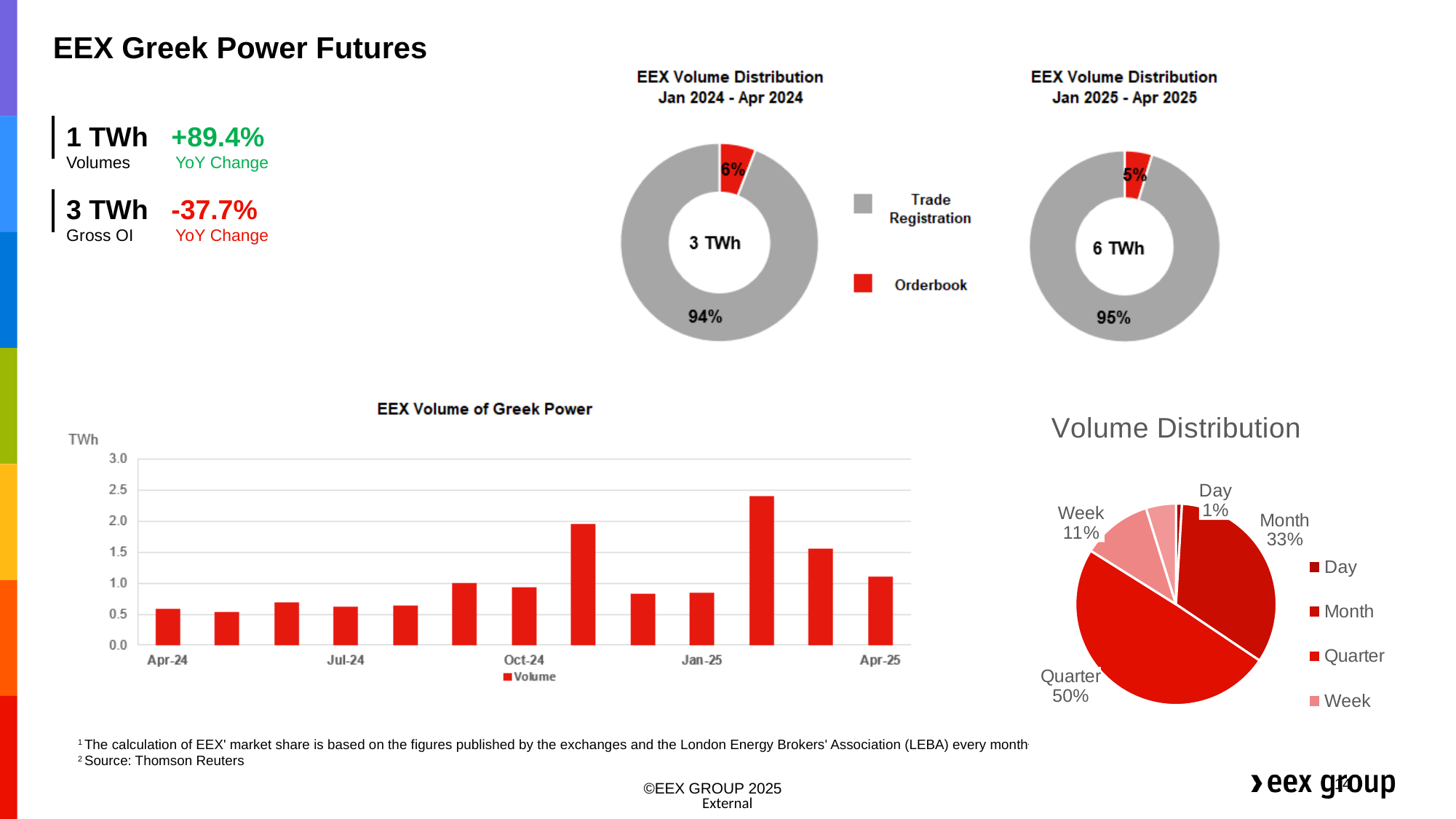
In the Volume Distribution pie chart, what is the difference between the Quarter and Month shares? 17% In the EEX Volume of Greek Power chart, is the value for Apr-24 greater or less than 1.0 TWh? less In the Volume Distribution pie chart, which category has the largest share? Quarter In the Volume Distribution pie chart, which category has the smallest share? Day What total volume is shown in the centre of the EEX Volume Distribution Jan 2025 - Apr 2025 donut chart? 6 TWh How many bars are plotted in the EEX Volume of Greek Power chart? 13 How many categories does the legend of the Volume Distribution pie chart list? 4 In the EEX Volume Distribution Jan 2025 - Apr 2025 donut chart, what share is Orderbook? 5% In the EEX Volume Distribution Jan 2024 - Apr 2024 donut chart, what share is Trade Registration? 94% What kind of chart is EEX Volume of Greek Power? Bar chart In the Volume Distribution pie chart, what share does Quarter have? 50% In the EEX Volume Distribution Jan 2024 - Apr 2024 donut chart, what is the difference between the Trade Registration and Orderbook shares? 88%